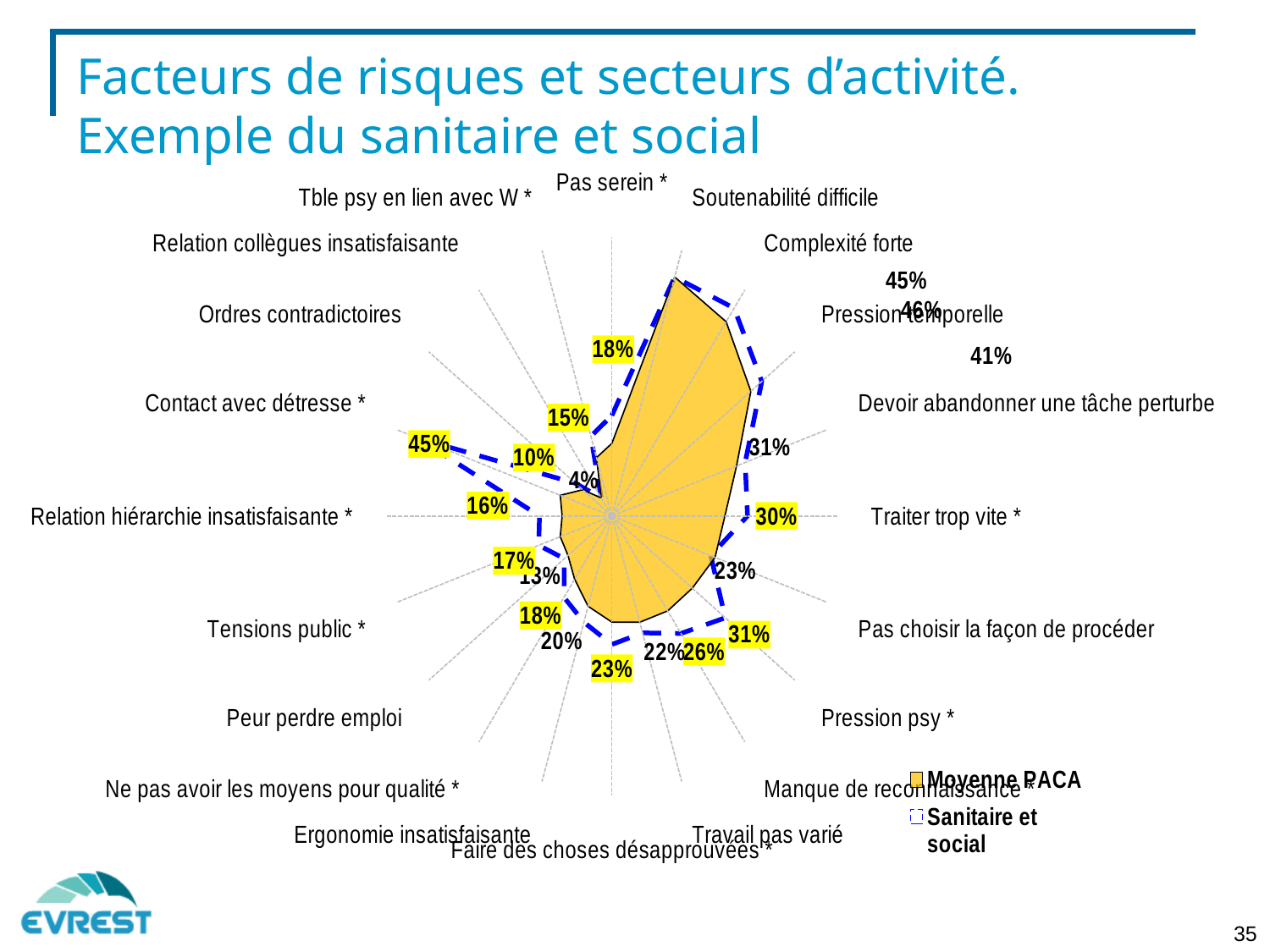
What is the value of Sanitaire et social for 'Contact avec détresse *'? 45% What are the two series named in the legend? Moyenne PACA and Sanitaire et social How many categories (axes) does the radar chart have? 20 For 'Relation hiérarchie insatisfaisante *', which series has the larger value, Moyenne PACA or Sanitaire et social? Sanitaire et social How many series does the legend list? 2 What is the value of Sanitaire et social for 'Traiter trop vite *'? 30% Which series is drawn as a dashed blue line? Sanitaire et social For 'Contact avec détresse *', which series has the larger value, Moyenne PACA or Sanitaire et social? Sanitaire et social What kind of chart is shown on the slide? Radar chart